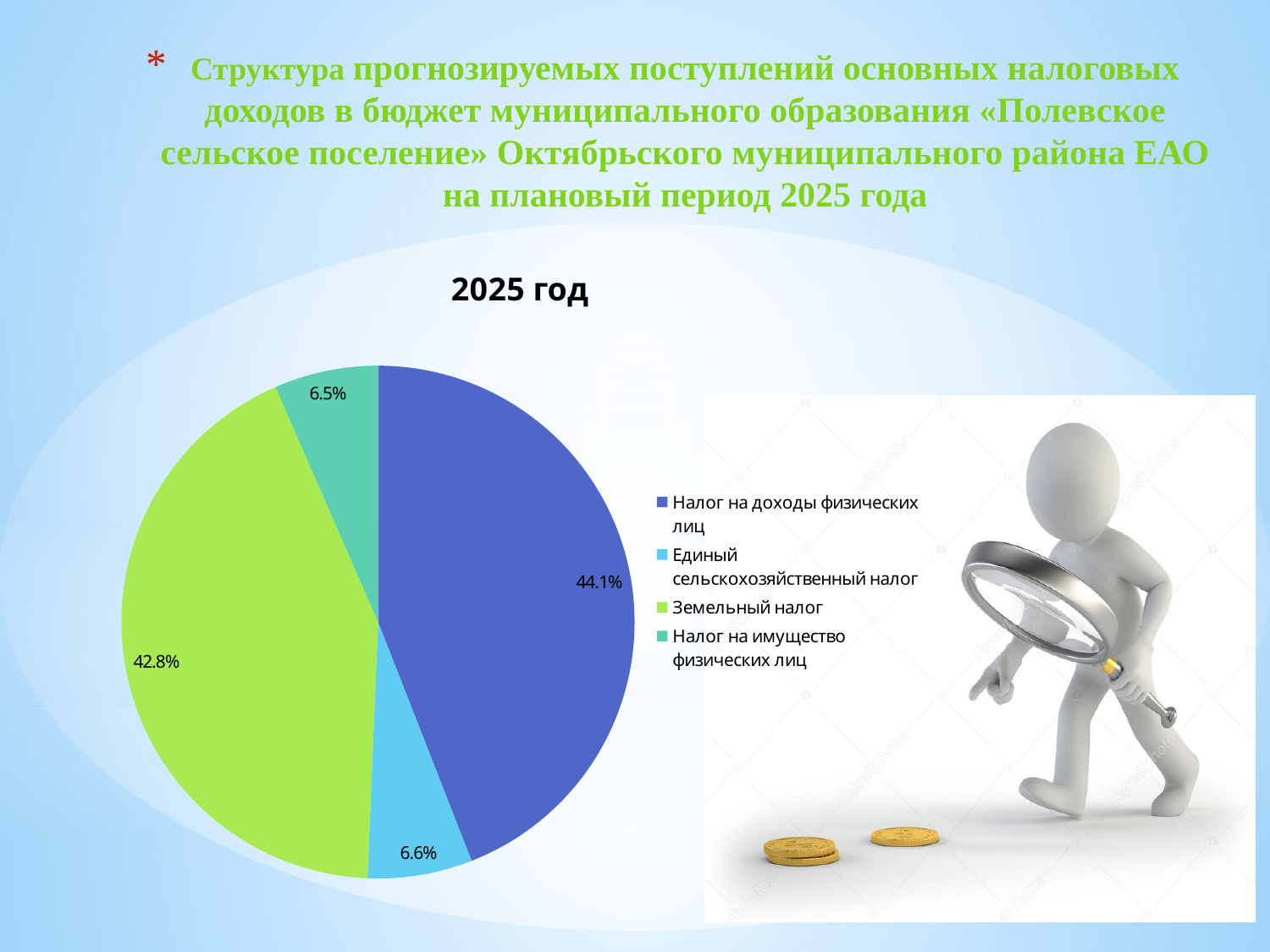
Which category has the largest slice of the pie? Налог на доходы физических лиц What is the title of the chart? 2025 год What kind of chart is shown on the slide? pie chart What share of the pie is Налог на имущество физических лиц? 6.5% Which is larger: the share of Земельный налог or the share of Единый сельскохозяйственный налог? Земельный налог How many slices does the pie chart have? 4 What share of the pie is Налог на доходы физических лиц? 44.1% What colour is the slice for Земельный налог? green What share of the pie is Единый сельскохозяйственный налог? 6.6% How many entries does the legend list? 4 What is the difference between the shares of Налог на доходы физических лиц and Земельный налог? 1.3%